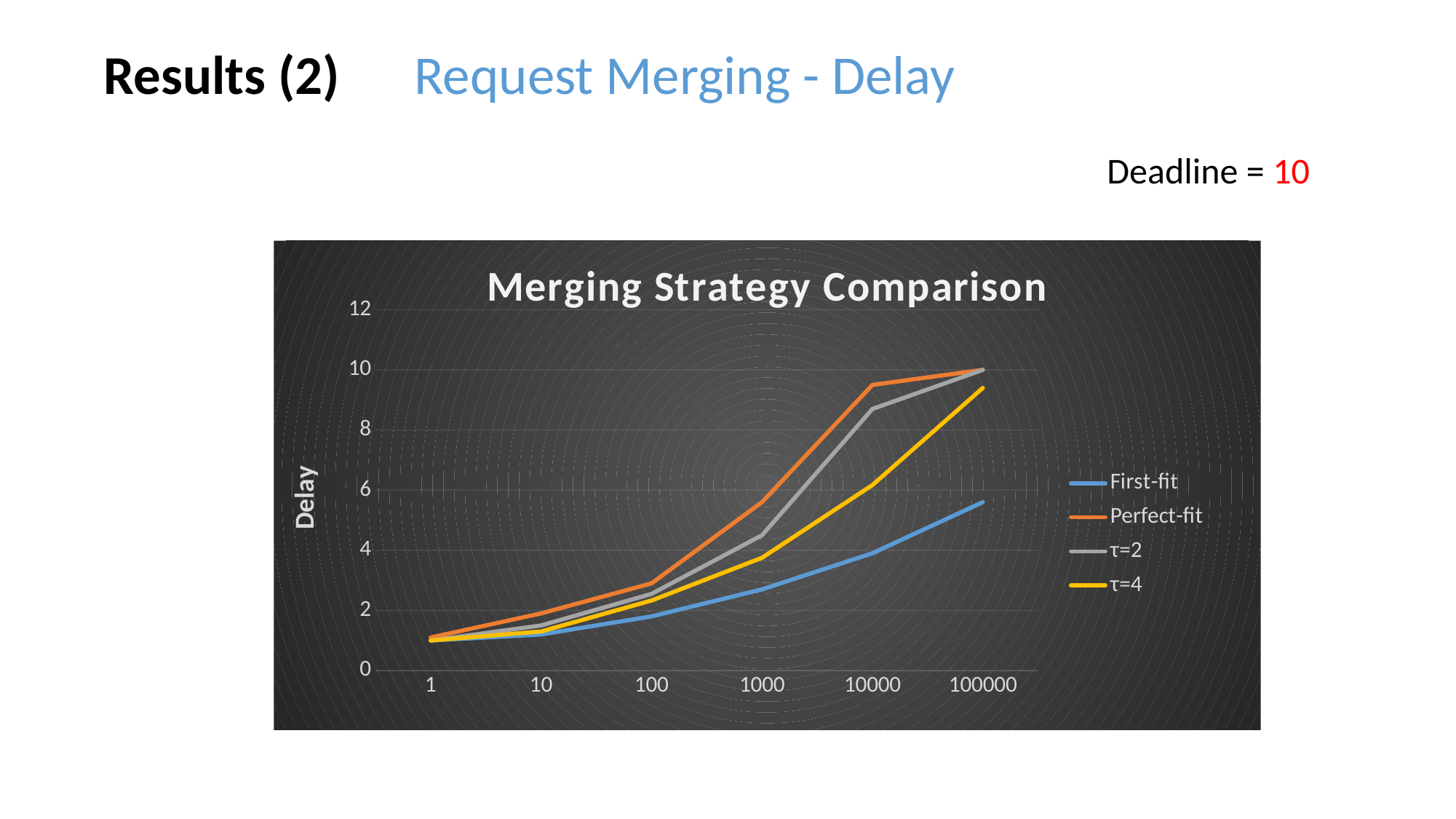
At x = 10000, which has the larger delay, τ=2 or τ=4? τ=2 Is the delay for τ=4 at x = 1000 greater or less than 4? less How many series does the legend of the chart list? 4 What is the label of the y axis of the chart? Delay How many points are on the x axis of the chart? 6 Which series has the lowest delay at x = 100000? First-fit What kind of chart is shown on the slide? line chart Is the delay for Perfect-fit at x = 10000 greater or less than 8? greater Does the delay for First-fit rise or fall as the x axis increases? rise What is the title of the chart? Merging Strategy Comparison Is the delay for First-fit at x = 100000 greater or less than 6? less At x = 10000, which has the larger delay, Perfect-fit or First-fit? Perfect-fit